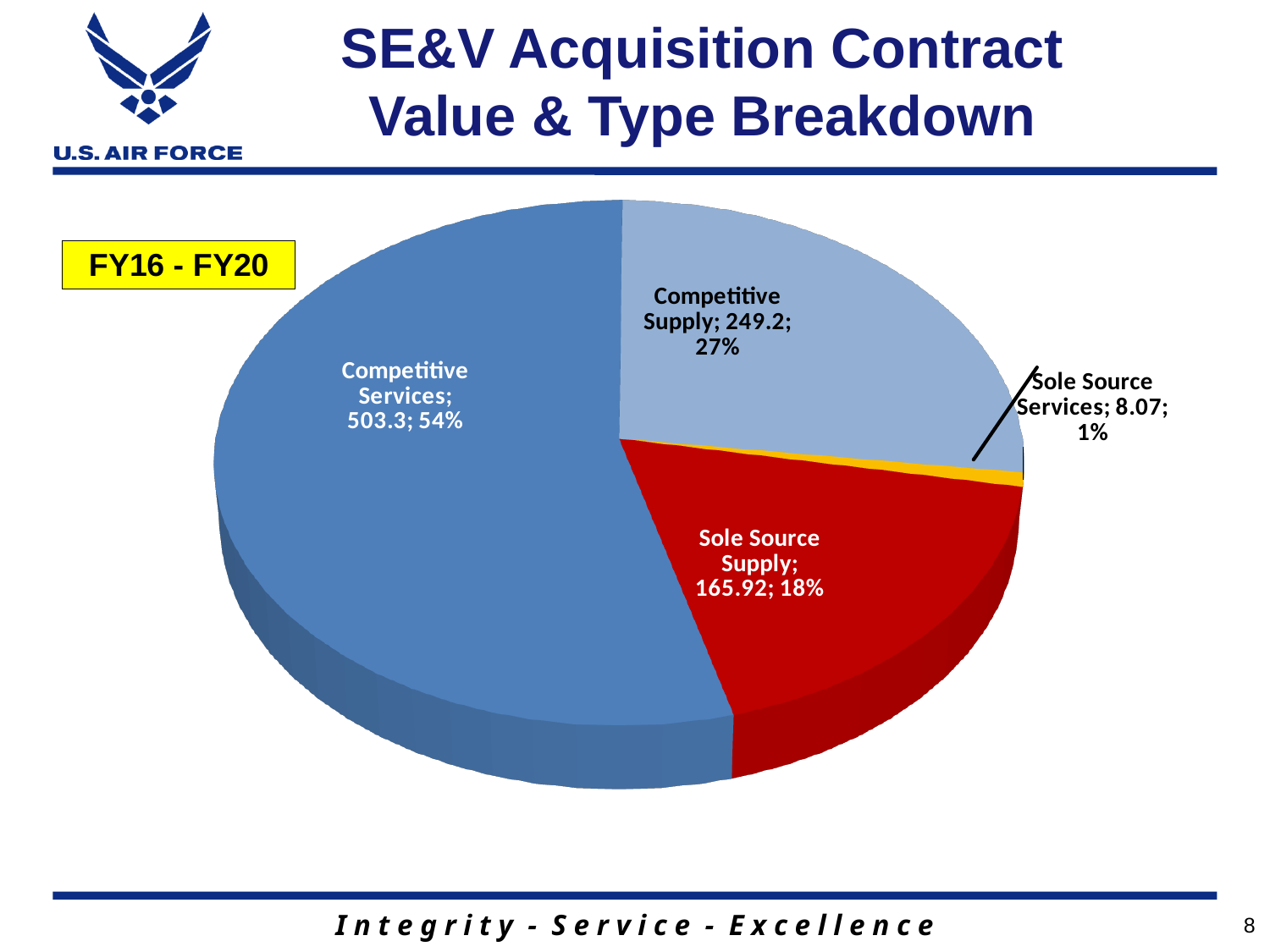
Which is larger, Competitive Supply or Sole Source Supply? Competitive Supply What is the value shown for Sole Source Services? 8.07 What kind of chart is shown on the slide? Pie chart What is the value shown for Competitive Supply? 249.2 How many slices does the pie chart have? 4 What share of the pie does Sole Source Supply represent? 18% Which category has the smallest slice of the pie? Sole Source Services What is the value shown for Sole Source Supply? 165.92 Which category has the largest slice of the pie? Competitive Services What fiscal year range is shown in the yellow box on the slide? FY16 - FY20 What share of the pie does Competitive Services represent? 54% What is the value shown for Competitive Services? 503.3